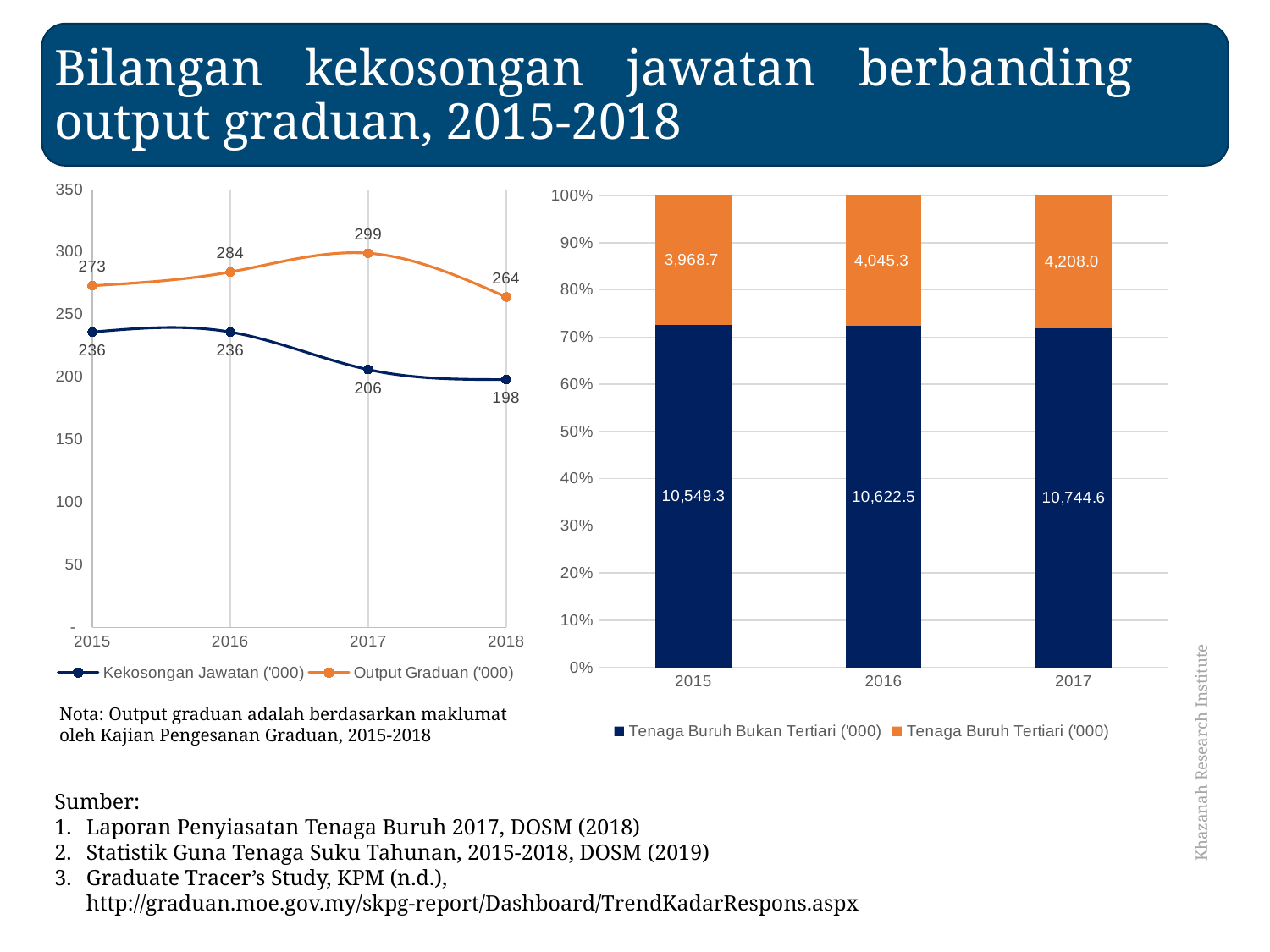
In the right stacked bar chart, what is the value for Tenaga Buruh Bukan Tertiari ('000) in 2017? 10,744.6 In the right stacked bar chart, what is the value for Tenaga Buruh Tertiari ('000) in 2016? 4,045.3 In the left line chart, does Kekosongan Jawatan ('000) rise or fall from 2016 to 2018? fall How many series does the legend of the left line chart list? 2 In the left line chart, which year has the highest value for Output Graduan ('000)? 2017 In the left line chart, what is the value for Output Graduan ('000) in 2017? 299 In the right stacked bar chart, which year has the highest value for Tenaga Buruh Bukan Tertiari ('000)? 2017 In the left line chart, which year has the lowest value for Kekosongan Jawatan ('000)? 2018 What kind of chart is the chart on the right side of the slide? stacked bar chart How many years are shown on the x axis of the right stacked bar chart? 3 In the left line chart, what is the difference between Output Graduan ('000) and Kekosongan Jawatan ('000) in 2016? 48 In the left line chart, what is the value for Kekosongan Jawatan ('000) in 2018? 198